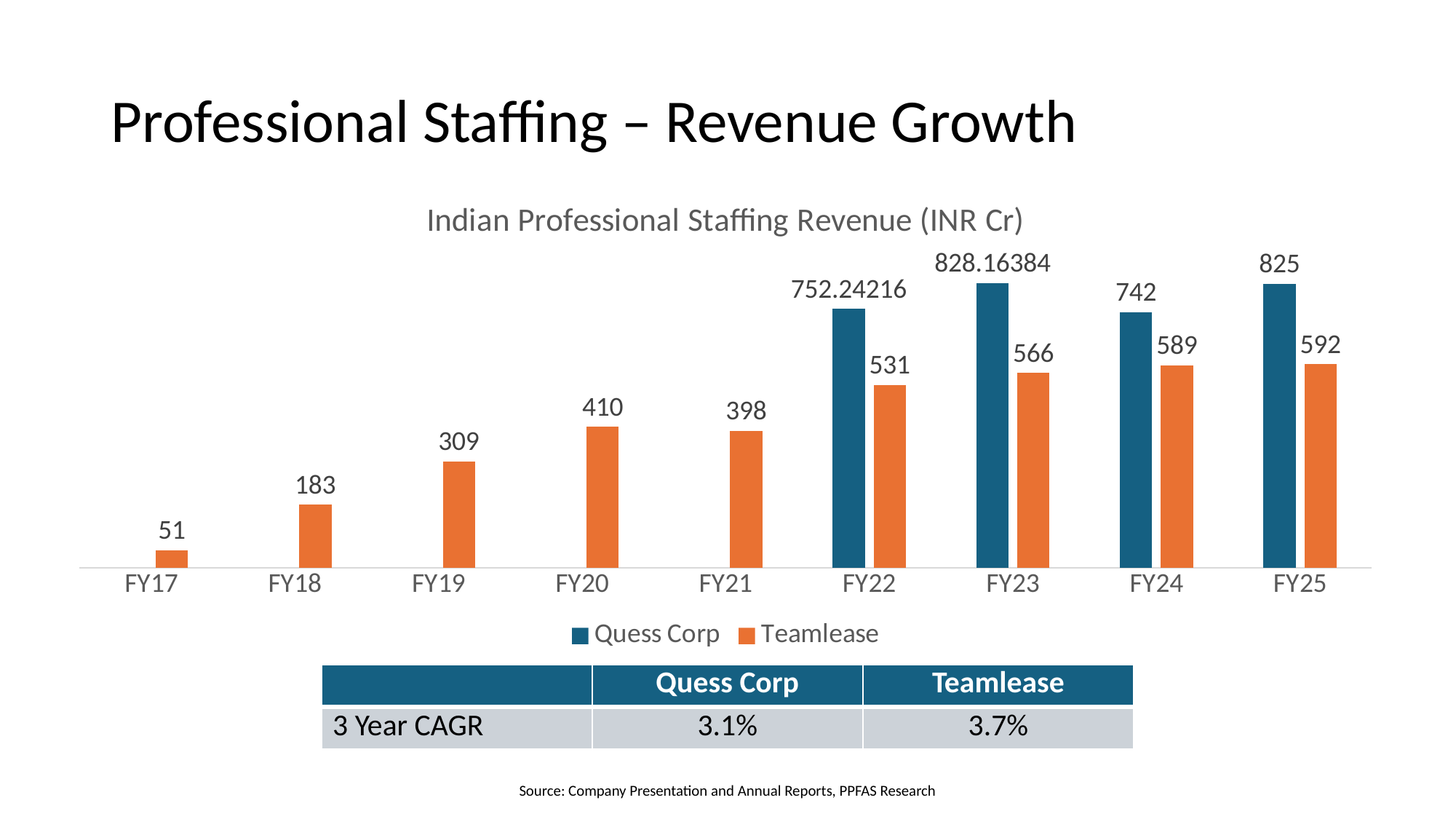
In which fiscal year is the Quess Corp revenue highest? FY23 What is the Teamlease revenue for FY20? 410 Which is larger in FY22, the Quess Corp revenue or the Teamlease revenue? Quess Corp What is the Teamlease revenue for FY25? 592 What kind of chart is shown? Bar chart What is the title of the chart? Indian Professional Staffing Revenue (INR Cr) What is the difference between the Quess Corp and Teamlease revenues in FY24? 153 How many series does the legend list? 2 What is the Quess Corp revenue for FY23? 828.16384 How many fiscal years are shown on the x axis? 9 In which fiscal year is the Teamlease revenue lowest? FY17 Does the Teamlease revenue rise or fall from FY17 to FY20? Rise